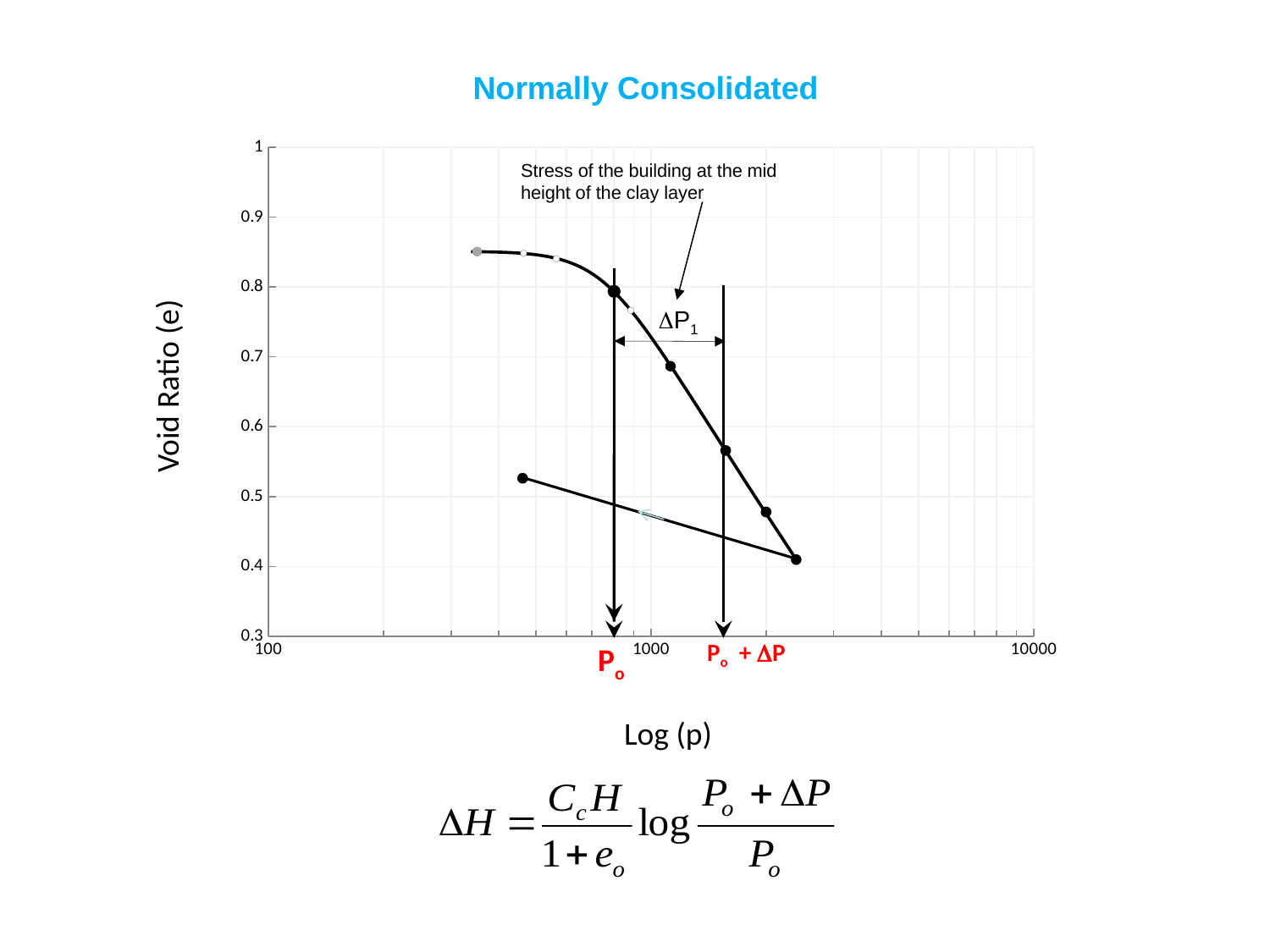
Does the void ratio along the main consolidation curve rise or fall as Log (p) increases? fall What is the maximum value shown on the vertical axis? 1 What is the title of the chart? Normally Consolidated What is the label of the vertical axis? Void Ratio (e) Is the void ratio at Po + ΔP on the main curve greater or less than 0.6? less What kind of chart is shown on the slide? line chart Is the highest void ratio plotted on the main curve greater or less than 0.8? greater Is the void ratio at Po on the main curve greater or less than 0.7? greater Which is larger, the void ratio at Po or the void ratio at Po + ΔP? Po